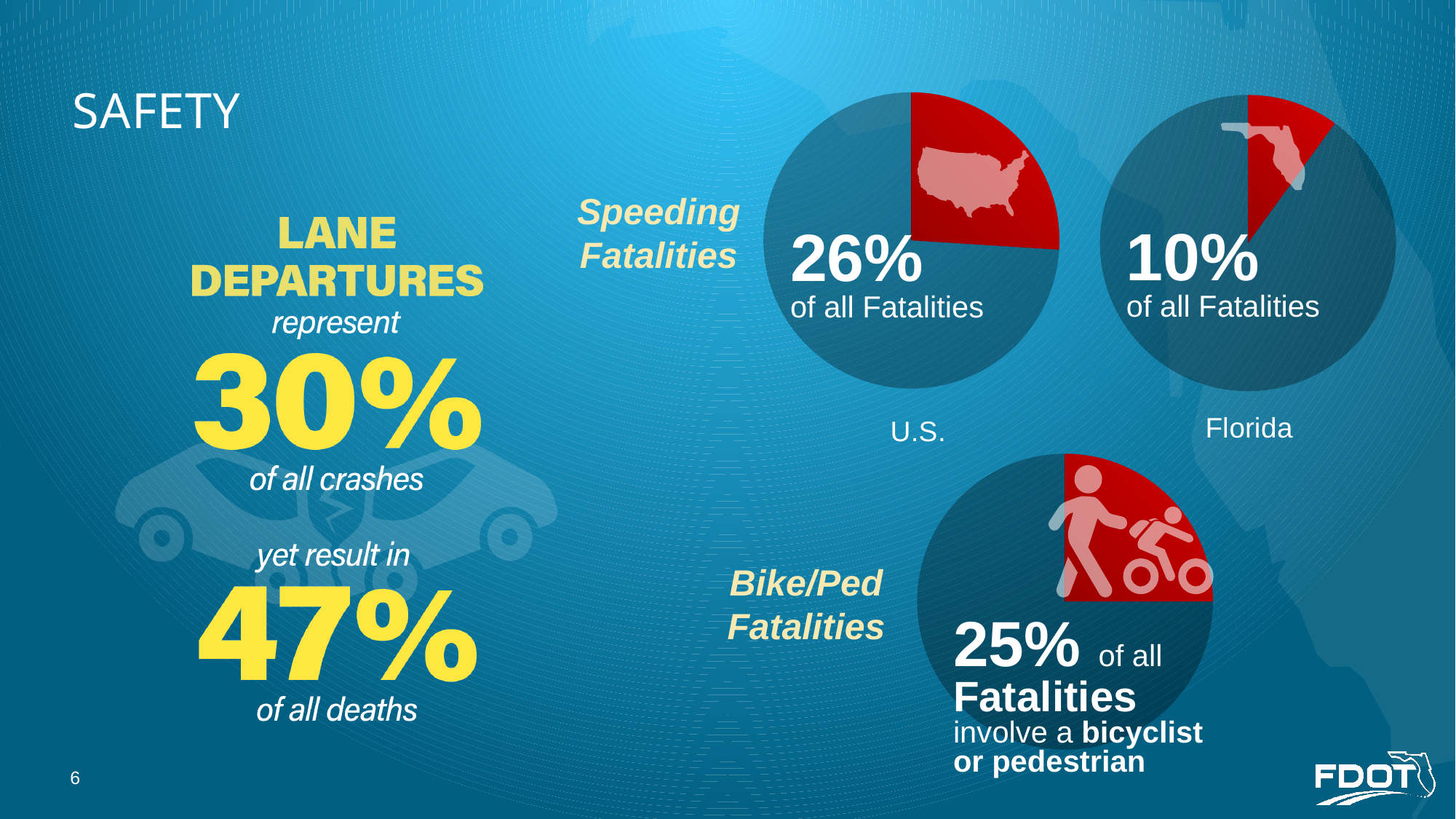
How many pie charts are shown on the slide? 3 In the Speeding Fatalities chart for Florida, what percentage of all fatalities is highlighted? 10% In the Speeding Fatalities chart for the U.S., what percentage of all fatalities is highlighted? 26% Comparing the two Speeding Fatalities charts, which has the larger highlighted share, U.S. or Florida? U.S. In the Florida Speeding Fatalities pie chart, what share of the pie is not highlighted? 90% What is the difference in percentage points between the U.S. and Florida speeding fatality shares? 16 percentage points What kind of chart is used to show the Speeding Fatalities figures? Pie chart What colour is used for the highlighted slice in each pie chart? Red Across the three pie charts on the slide, which one shows the smallest highlighted share? Speeding Fatalities Florida (10%) Across the three pie charts on the slide, which one shows the largest highlighted share? Speeding Fatalities U.S. (26%) Which pie chart contains an outline of the state of Florida inside its highlighted slice? The Florida Speeding Fatalities chart In the Bike/Ped Fatalities chart, what percentage of all fatalities involve a bicyclist or pedestrian? 25%